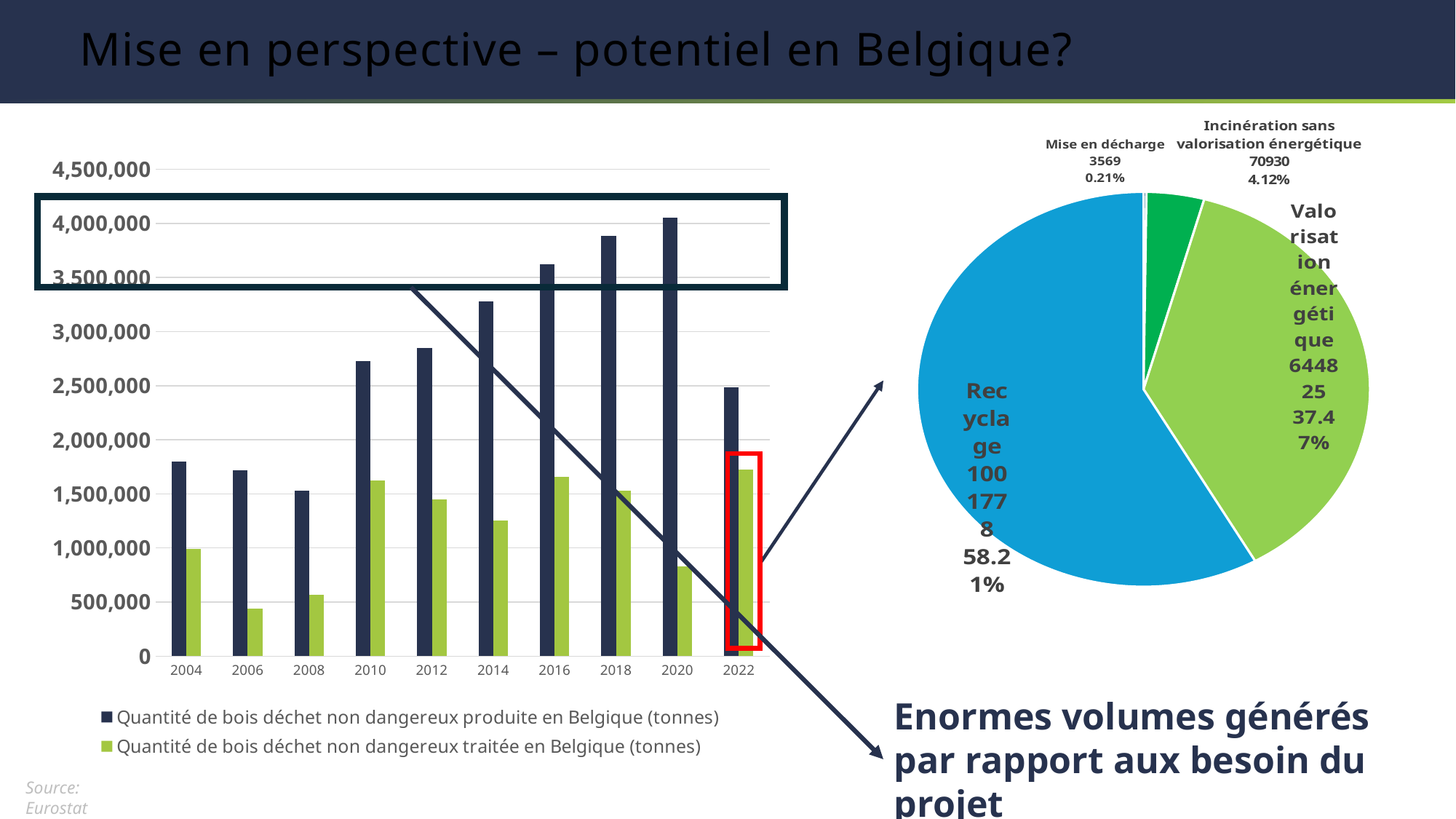
In the pie chart on the right, which category has the smallest slice? Mise en décharge In the bar chart on the left, how many series does the legend list? 2 What kind of chart is the chart on the left of the slide? Bar chart In the pie chart on the right, what share of the pie does 'Valorisation énergétique' represent? 37.47% In the bar chart on the left, which year has the larger value for 'Quantité de bois déchet non dangereux produite en Belgique (tonnes)', 2020 or 2022? 2020 In the bar chart on the left, is the value for 'Quantité de bois déchet non dangereux produite en Belgique (tonnes)' in 2020 greater or less than 3,500,000? greater In the bar chart on the left, which year has the highest value for 'Quantité de bois déchet non dangereux produite en Belgique (tonnes)'? 2020 In the pie chart on the right, what is the difference between the values for 'Valorisation énergétique' and 'Incinération sans valorisation énergétique'? 573895 In the bar chart on the left, which year has the lowest value for 'Quantité de bois déchet non dangereux traitée en Belgique (tonnes)'? 2006 In the bar chart on the left, how many years are shown on the x axis? 10 In the bar chart on the left, is the value for 'Quantité de bois déchet non dangereux traitée en Belgique (tonnes)' in 2020 greater or less than 1,000,000? less In the pie chart on the right, what is the value shown for 'Recyclage'? 1001778